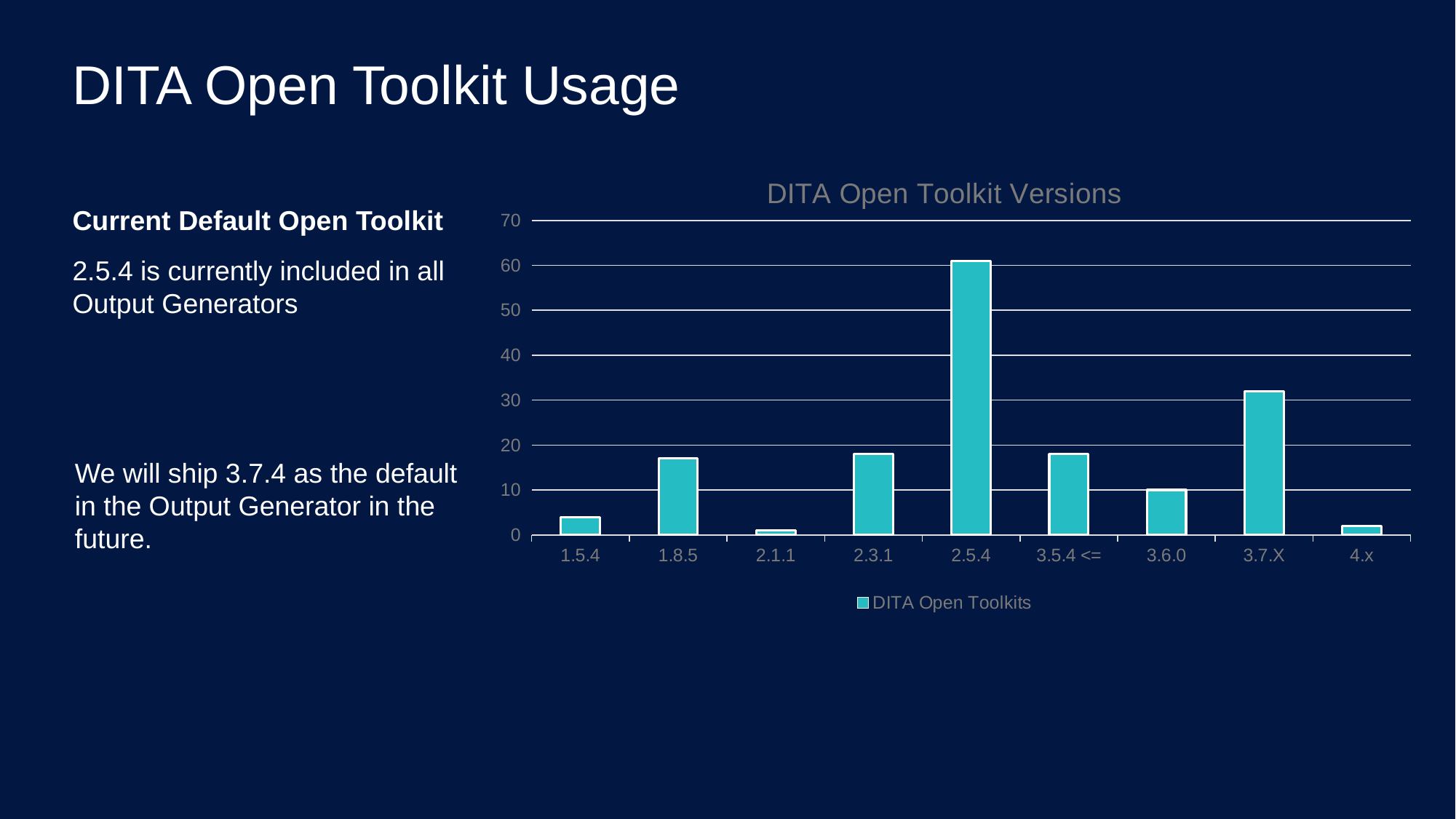
What kind of chart is shown on the slide? bar chart Which has a larger value, 3.7.X or 1.8.5? 3.7.X How many series does the legend list? 1 What is the name of the series shown in the legend? DITA Open Toolkits Which version has the lowest value? 2.1.1 What is the title of the chart? DITA Open Toolkit Versions Which has a larger value, 2.5.4 or 3.7.X? 2.5.4 Is the value for 2.5.4 greater or less than 50? greater Is the value for 1.5.4 greater or less than 10? less Is the value for 3.7.X greater or less than 40? less How many version categories are shown on the x axis? 9 Which version has the highest value? 2.5.4